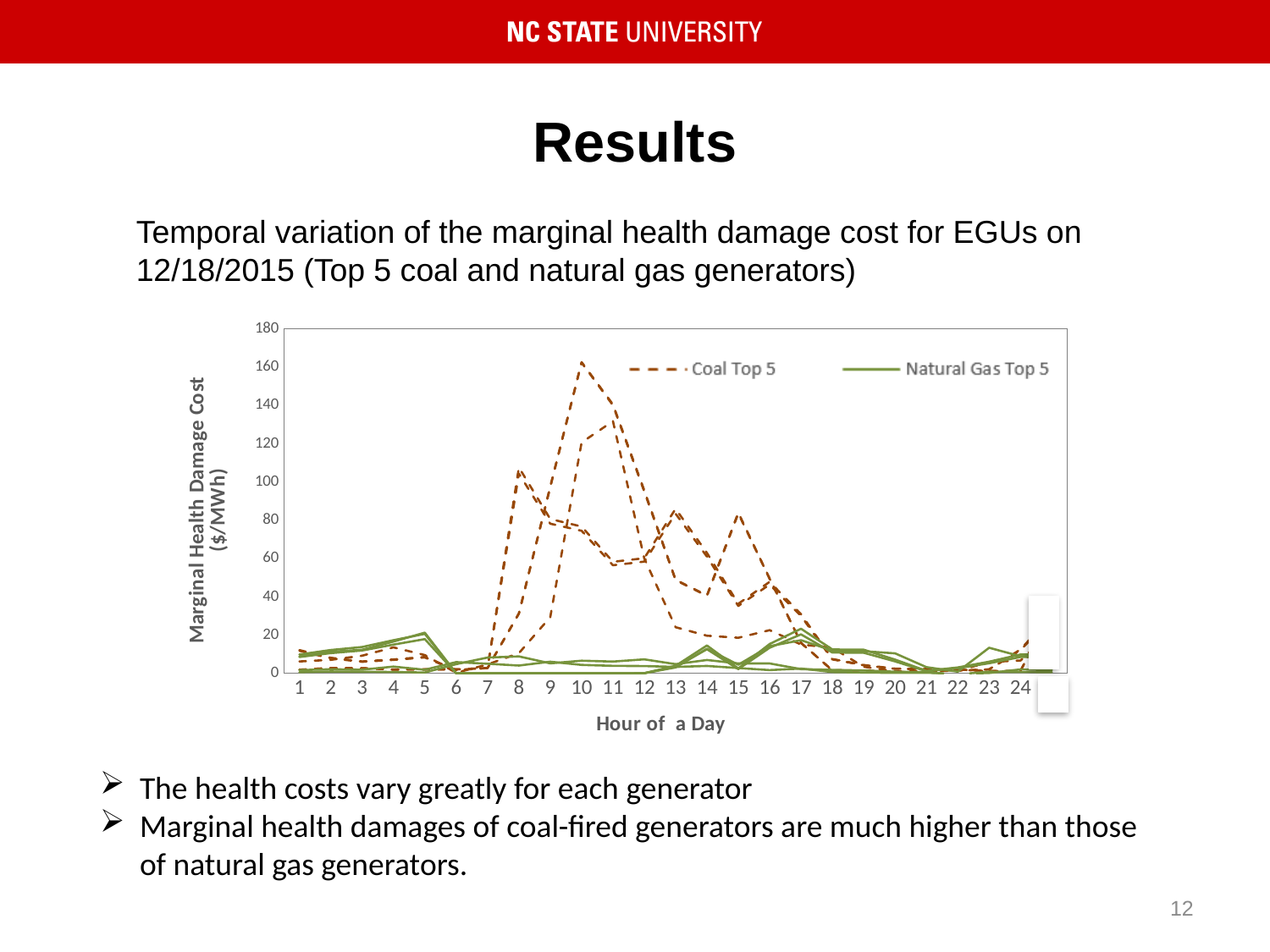
What is the maximum value shown on the y axis of the chart? 180 What kind of chart is shown on the slide? Line chart What is the title of the y axis of the chart? Marginal Health Damage Cost ($/MWh) Is the highest Coal Top 5 value at hour 15 greater or less than 60? greater At which hour of the day does the highest Coal Top 5 value occur? 10 What are the two series named in the chart legend? Coal Top 5 and Natural Gas Top 5 Which series reaches higher marginal health damage costs, Coal Top 5 or Natural Gas Top 5? Coal Top 5 Are all Natural Gas Top 5 values greater or less than 40? less Do the Coal Top 5 values rise or fall from hour 10 to hour 14? fall How many hours are shown along the x axis of the chart? 24 Is the peak Coal Top 5 value at hour 10 greater or less than 140? greater How many series does the chart legend list? 2